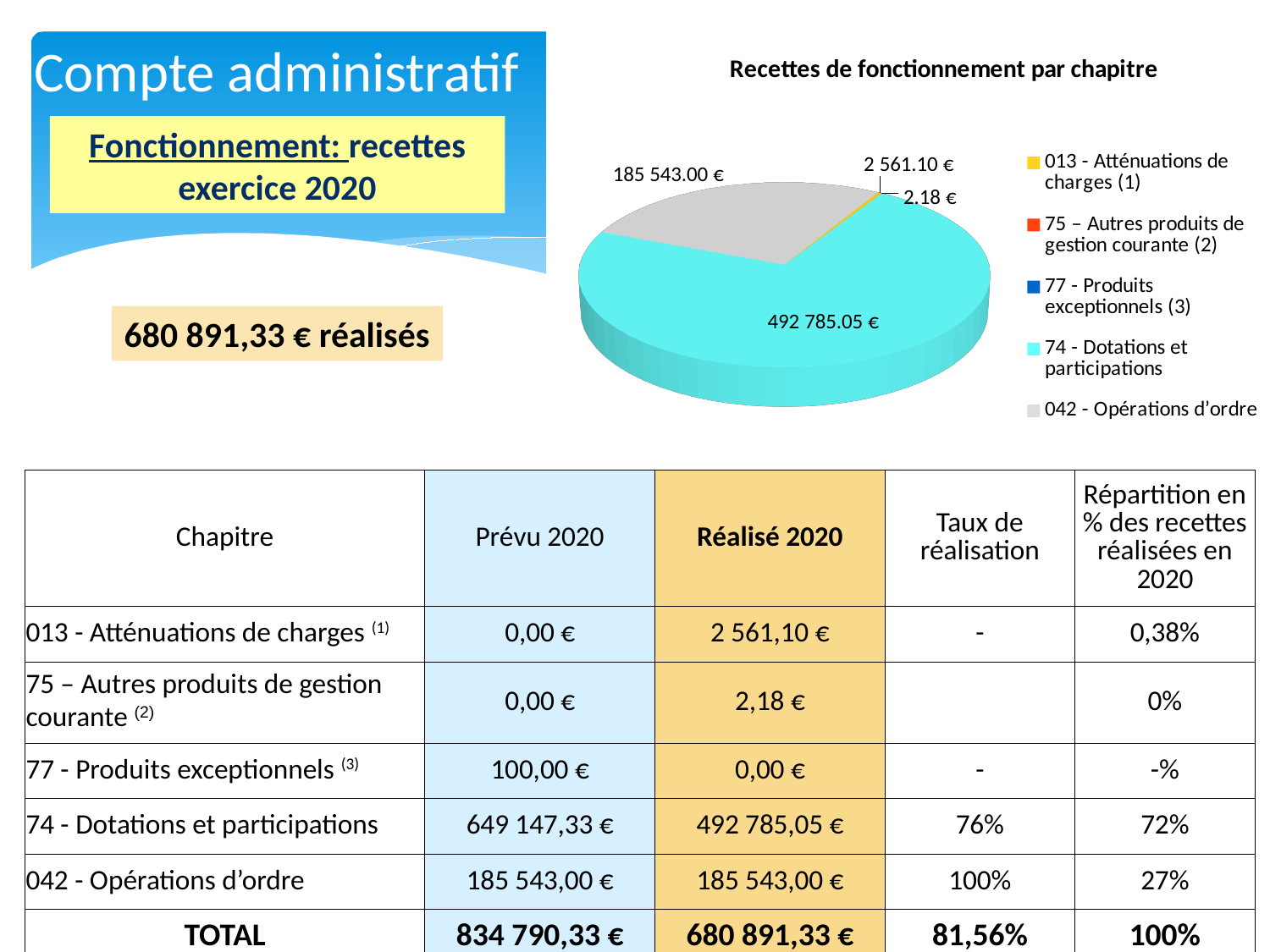
In the pie chart, what is the value shown for 74 - Dotations et participations? 492 785.05 € What colour is the slice for 74 - Dotations et participations in the pie chart? light blue (cyan) In the pie chart, what is the value shown for 75 – Autres produits de gestion courante (2)? 2.18 € What type of chart is shown on the slide? pie chart Which category has the largest slice in the pie chart? 74 - Dotations et participations In the pie chart, what is the value shown for 042 - Opérations d'ordre? 185 543.00 € In the pie chart, what is the value shown for 013 - Atténuations de charges (1)? 2 561.10 € What is the title of the chart on the slide? Recettes de fonctionnement par chapitre Which of the labelled slices in the pie chart has the smallest value? 75 – Autres produits de gestion courante (2) In the pie chart, which is larger: the value for 042 - Opérations d'ordre or the value for 013 - Atténuations de charges (1)? 042 - Opérations d'ordre How many categories does the legend of the pie chart list? 5 What is the difference between the values for 74 - Dotations et participations and 042 - Opérations d'ordre in the pie chart? 307 242.05 €